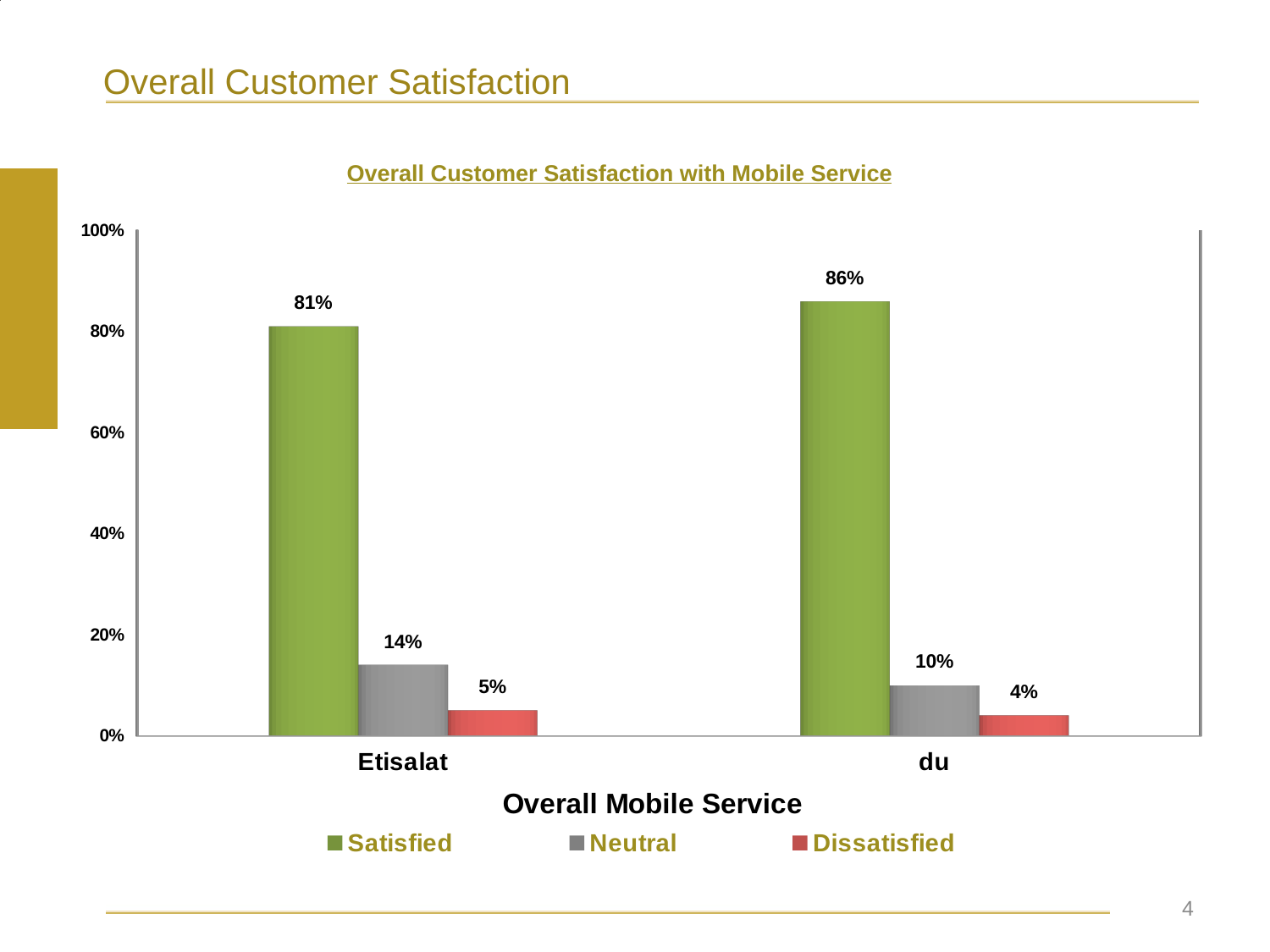
How many providers are shown on the x axis? 2 Which provider has the lower Dissatisfied value? du What is the Satisfied value for Etisalat? 81% What is the difference between the Satisfied values for du and Etisalat? 5% What is the title of the chart? Overall Customer Satisfaction with Mobile Service What kind of chart is shown? bar chart What is the Neutral value for du? 10% What is the Dissatisfied value for Etisalat? 5% Is the Neutral value for Etisalat larger or smaller than the Neutral value for du? larger Is the Satisfied value for du greater or less than 80%? greater Which provider has the higher Satisfied value? du How many series does the legend list? 3